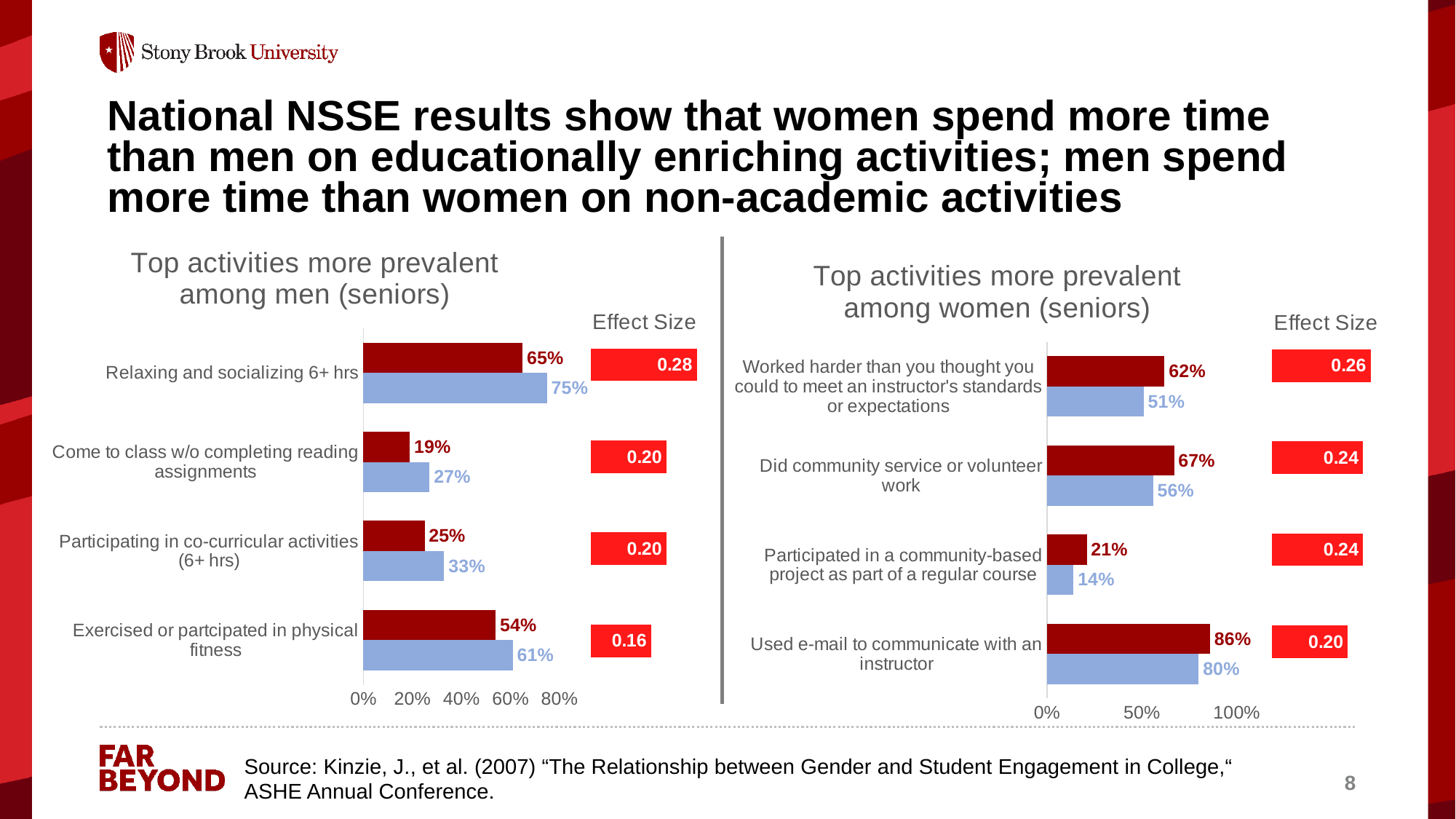
In the chart 'Top activities more prevalent among men (seniors)', which category has the highest light blue bar? Relaxing and socializing 6+ hrs In the chart 'Top activities more prevalent among men (seniors)', what is the value of the light blue bar for 'Come to class w/o completing reading assignments'? 27% How many categories are shown in the chart 'Top activities more prevalent among women (seniors)'? 4 In the chart 'Top activities more prevalent among women (seniors)', which category has the lowest dark red bar? Participated in a community-based project as part of a regular course In the chart 'Top activities more prevalent among men (seniors)', what is the value of the dark red bar for 'Relaxing and socializing 6+ hrs'? 65% What kind of chart is 'Top activities more prevalent among men (seniors)'? bar chart In the chart 'Top activities more prevalent among men (seniors)', what is the difference between the light blue and dark red bars for 'Exercised or partcipated in physical fitness'? 7% In the chart 'Top activities more prevalent among men (seniors)', which is larger for 'Participating in co-curricular activities (6+ hrs)': the dark red bar or the light blue bar? the light blue bar In the chart 'Top activities more prevalent among women (seniors)', what is the value of the light blue bar for 'Participated in a community-based project as part of a regular course'? 14% In the chart 'Top activities more prevalent among women (seniors)', what is the value of the dark red bar for 'Did community service or volunteer work'? 67% In the chart 'Top activities more prevalent among women (seniors)', what effect size is shown for 'Worked harder than you thought you could to meet an instructor's standards or expectations'? 0.26 In the chart 'Top activities more prevalent among women (seniors)', what is the difference between the dark red and light blue bars for 'Used e-mail to communicate with an instructor'? 6%